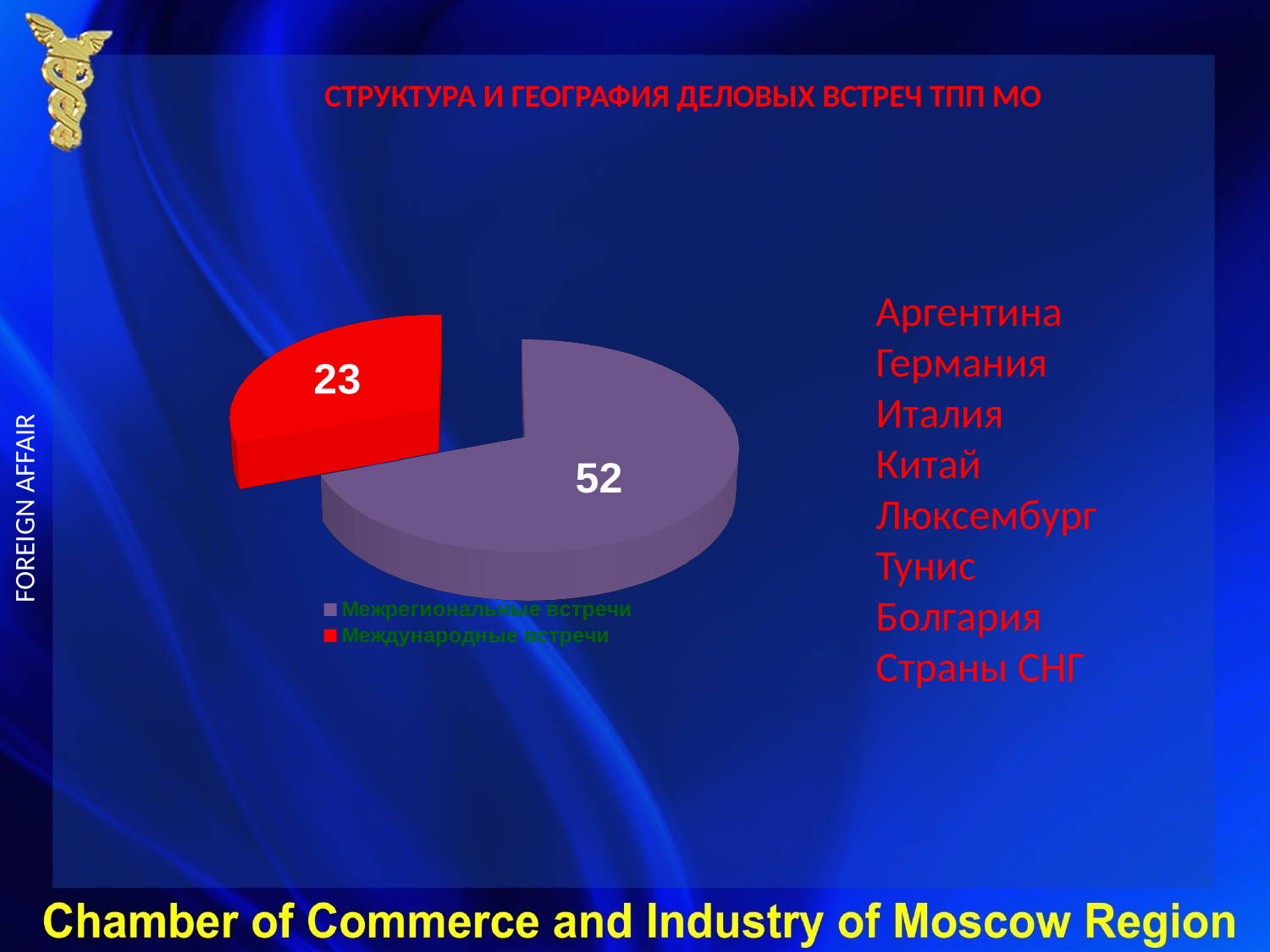
What is the total of the two values shown in the pie chart? 75 What colour is the slice for Международные встречи in the pie chart? red What is the difference between the values for Межрегиональные встречи and Международные встречи? 29 How many entries does the legend of the pie chart list? 2 What type of chart is shown on the slide? pie chart What is the value for Международные встречи in the pie chart? 23 What share of the total do Международные встречи represent in the pie chart? 30.7% Which is larger: the value for Межрегиональные встречи or the value for Международные встречи? Межрегиональные встречи What is the value for Межрегиональные встречи in the pie chart? 52 Which category has the largest slice in the pie chart? Межрегиональные встречи Which category has the smallest slice in the pie chart? Международные встречи How many slices does the pie chart have? 2